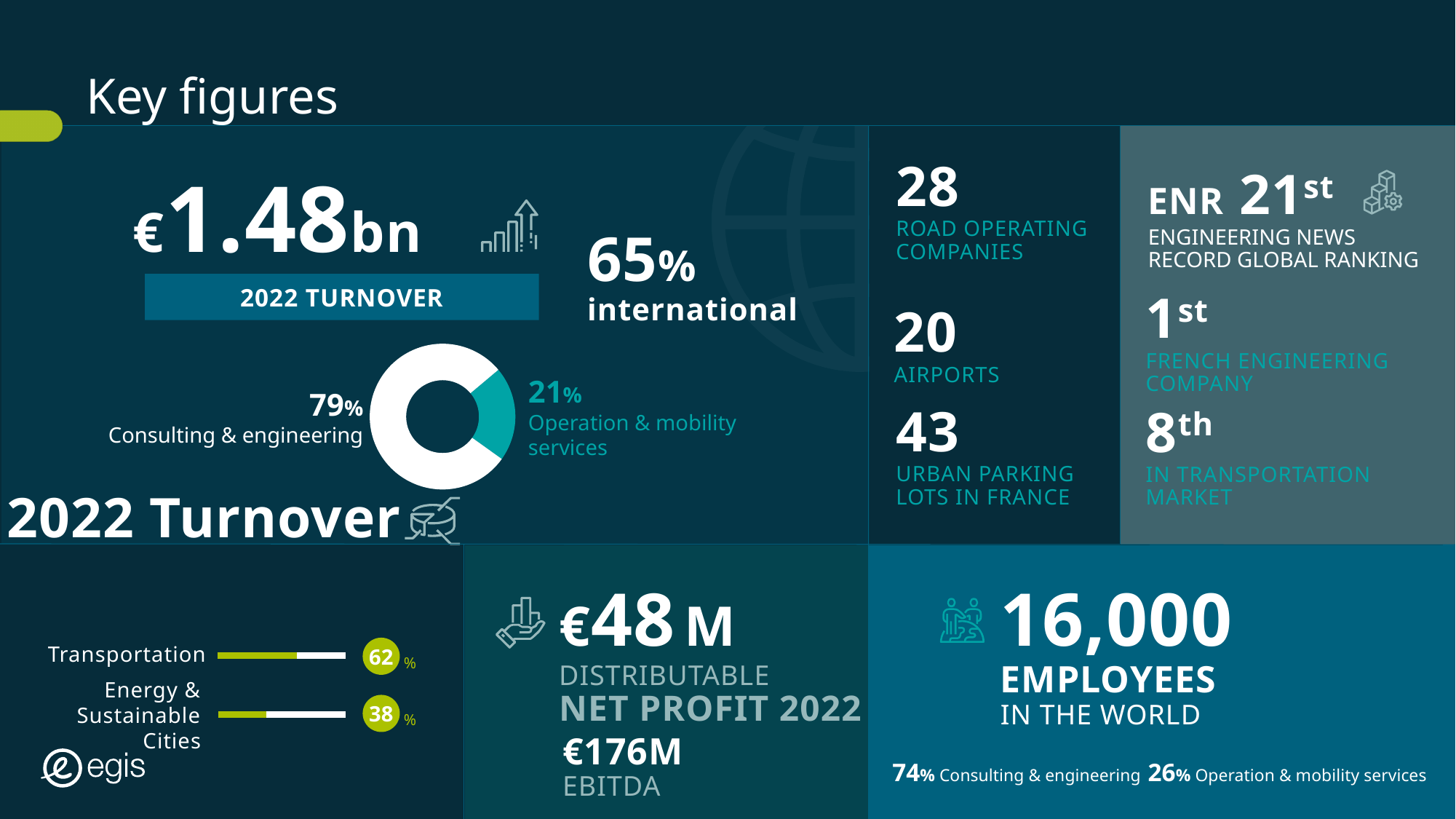
In the donut chart, what share of 2022 turnover comes from Operation & mobility services? 21% In the bar chart at the bottom left, what is the difference in percentage points between Transportation and Energy & Sustainable Cities? 24 In the donut chart, what is the difference in percentage points between Consulting & engineering and Operation & mobility services? 58 In the donut chart, which segment is the largest? Consulting & engineering What kind of chart shows the split between Consulting & engineering and Operation & mobility services? Donut chart In the bar chart at the bottom left, what is the value for Energy & Sustainable Cities? 38% What kind of chart is used at the bottom left for Transportation and Energy & Sustainable Cities? Bar chart In the bar chart at the bottom left, what is the value for Transportation? 62% How many segments does the donut chart have? 2 In the donut chart, what share of 2022 turnover comes from Consulting & engineering? 79% In the donut chart, which segment is the smallest? Operation & mobility services In the bar chart at the bottom left, which category has the higher value, Transportation or Energy & Sustainable Cities? Transportation